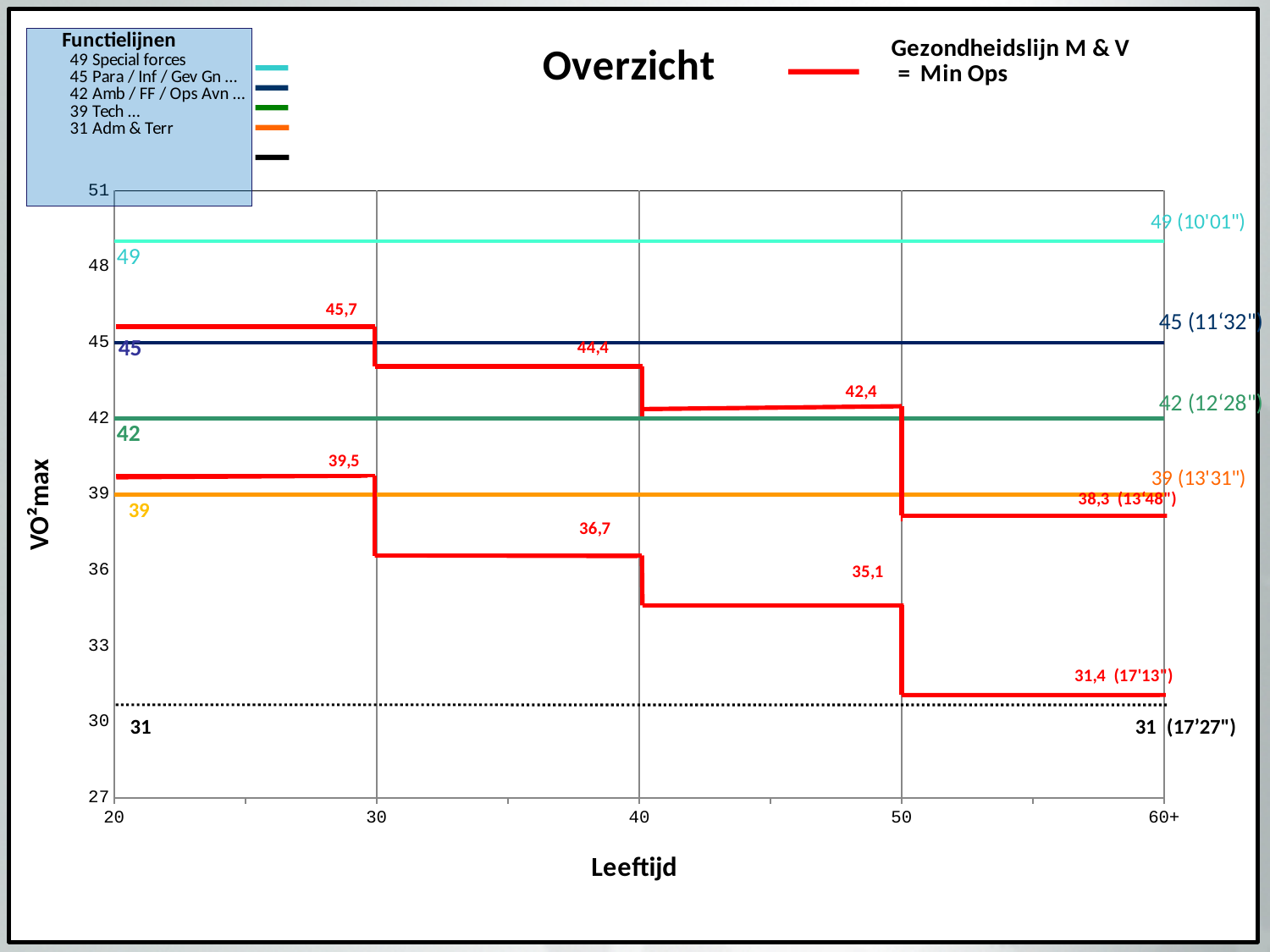
What is the title of the chart? Overzicht What is the difference between the upper red line values for the 20–30 and 30–40 age groups (45,7 and 44,4)? 1,3 What is the label of the y axis? VO²max What is the VO²max value of the Special forces function line? 49 What is the value of the upper red health line for the 30–40 age group? 44,4 Which is larger: the lower red line value for the 30–40 age group or for the 40–50 age group? 30–40 age group (36,7) Do the red health line values rise or fall as age increases along the x axis? fall What type of chart is shown on the slide? line chart What is the value of the upper red health line for the 20–30 age group? 45,7 Is the upper red line value for the 50–60+ age group greater or less than 39? less What is the value of the lower red health line for the 40–50 age group? 35,1 What is the value of the lower red health line for the 50–60+ age group? 31,4